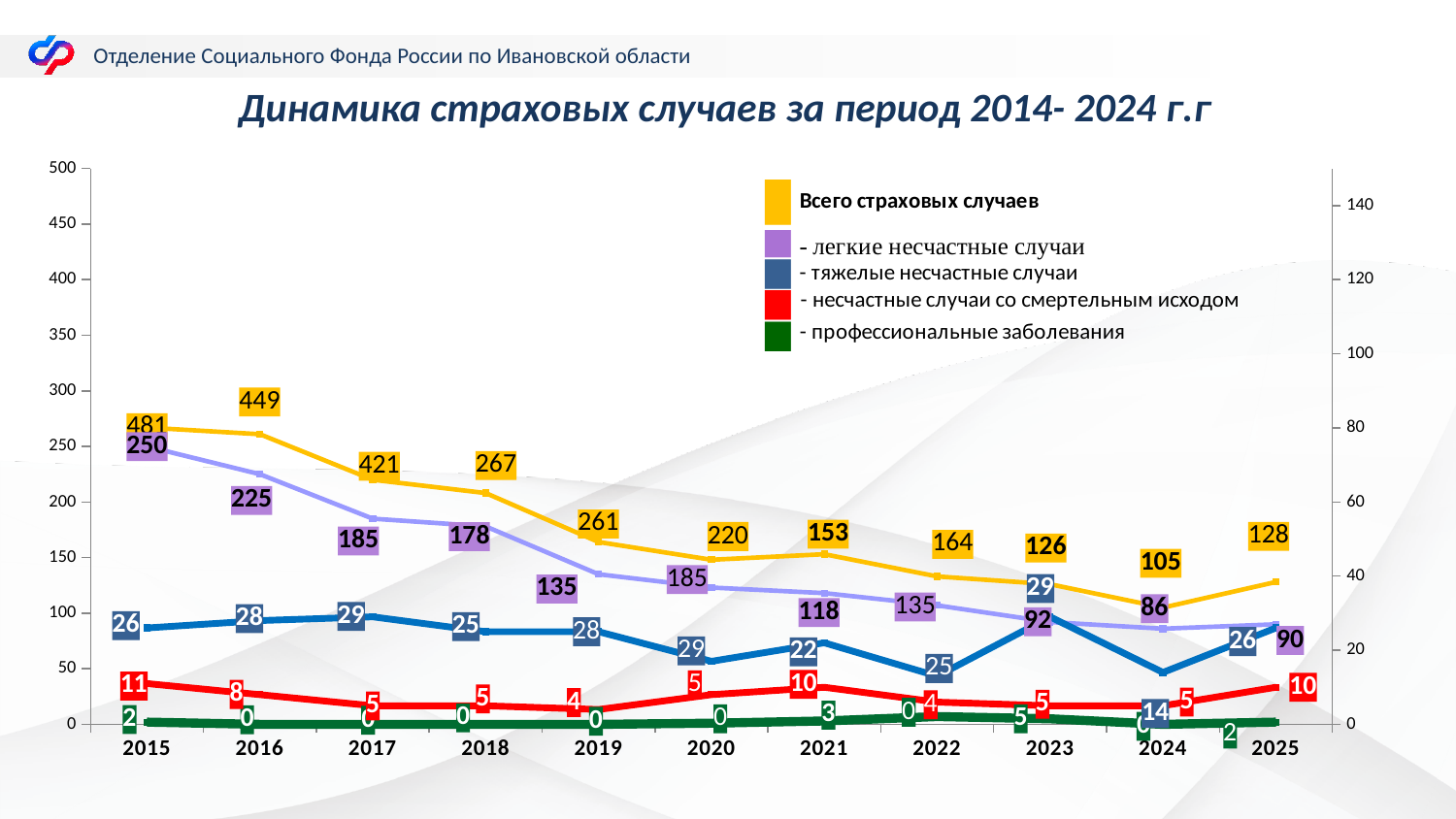
What kind of chart is shown on the slide? line chart What is the difference between 'Всего страховых случаев' in 2015 and in 2025? 353 Which year has the larger value for 'легкие несчастные случаи', 2016 or 2017? 2016 In which year is 'Всего страховых случаев' highest? 2015 What is the value of 'Всего страховых случаев' for 2015? 481 Does 'Всего страховых случаев' generally rise or fall from 2015 to 2024? fall What is the value of 'несчастные случаи со смертельным исходом' for 2021? 10 How many series does the legend list? 5 In which year is 'Всего страховых случаев' lowest? 2024 How many years are plotted along the x axis? 11 What is the value of 'тяжелые несчастные случаи' for 2024? 14 What is the value of 'Всего страховых случаев' for 2024? 105